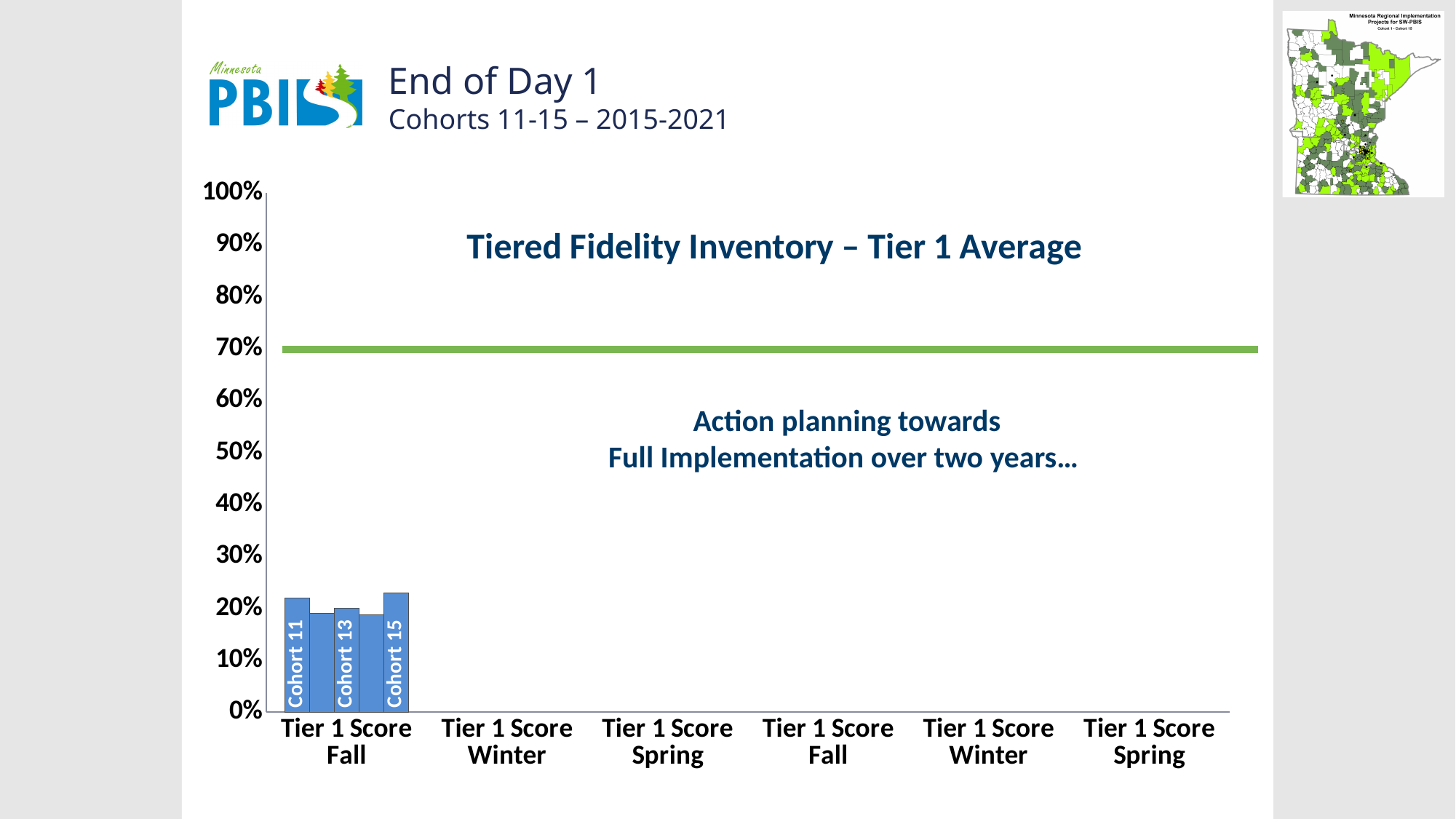
What is the highest value shown on the y axis of the chart? 100% Is the value for Cohort 11 in the Tier 1 Score Fall category greater or less than 30%? less Is the value for Cohort 15 in the Tier 1 Score Fall category greater or less than 10%? greater At what percentage level is the horizontal green line drawn on the chart? 70% How many categories are labelled along the x axis of the chart? 6 What is the title of the chart? Tiered Fidelity Inventory – Tier 1 Average What kind of chart is shown on the slide? bar chart Is the value for Cohort 13 in the Tier 1 Score Fall category greater or less than 30%? less